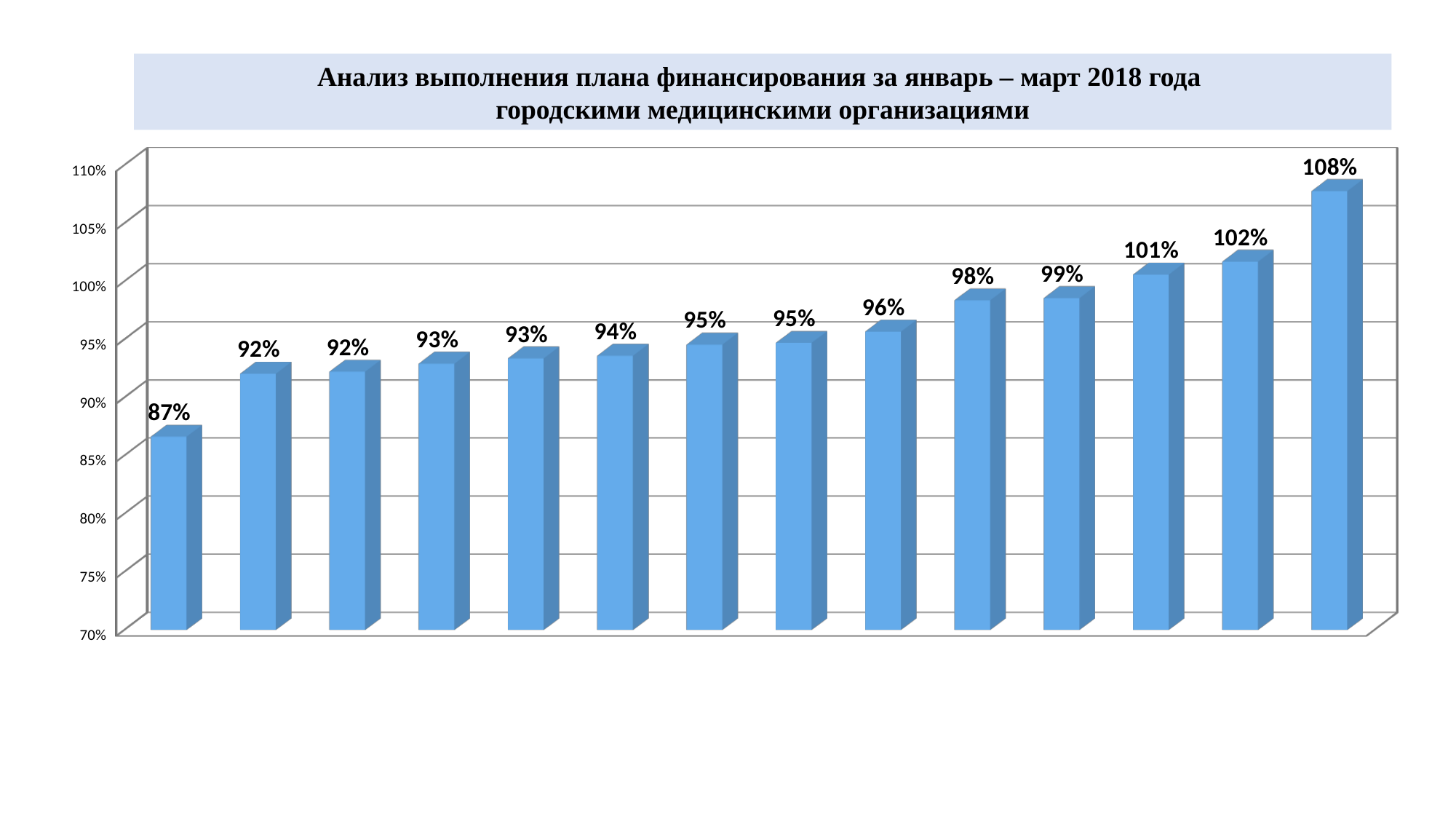
How many bars have values above 100%? 3 How many bars are plotted in the chart? 14 Is the value of the leftmost bar greater or less than 90%? less What period does the chart title say the analysis covers? январь – март 2018 года What is the value of the first (leftmost) bar? 87% Do the values rise or fall from left to right along the x axis? rise What is the lowest value shown in the chart? 87% What is the difference between the highest and lowest values in the chart? 21% What kind of chart is shown on the slide? bar chart What is the value of the tenth bar from the left? 98% What is the value of the last (rightmost) bar? 108% What is the highest value shown in the chart? 108%